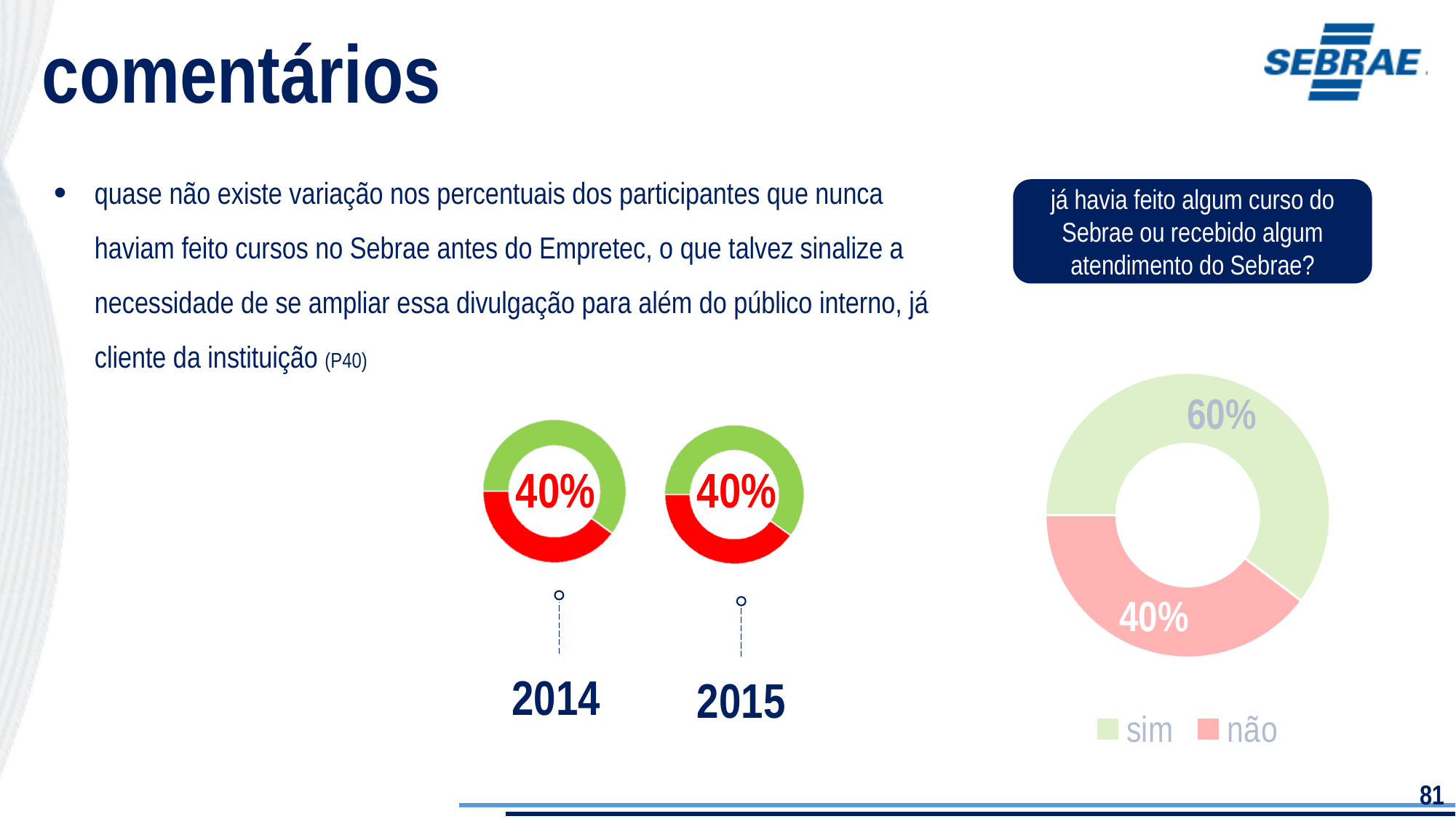
Does the percentage shown in the small donut charts rise, fall or stay the same from 2014 to 2015? Stays the same How many small donut charts with year labels are shown in the middle of the slide? 2 How many entries does the legend of the large donut chart on the right list? 2 In the large donut chart on the right, what is the difference in percentage points between "sim" and "não"? 20 In the large donut chart on the right, what percentage is shown for "sim"? 60% In the small donut chart labelled 2015, what percentage is printed in the centre? 40% In the small donut chart labelled 2014, what percentage is printed in the centre? 40% In the large donut chart on the right, what percentage is shown for "não"? 40% In the large donut chart on the right, which colour represents "não"? Red (pink) What kind of chart is the large chart on the right of the slide? Donut chart In the large donut chart on the right, which category has the larger share, "sim" or "não"? sim In the large donut chart on the right, which category has the smallest share? não